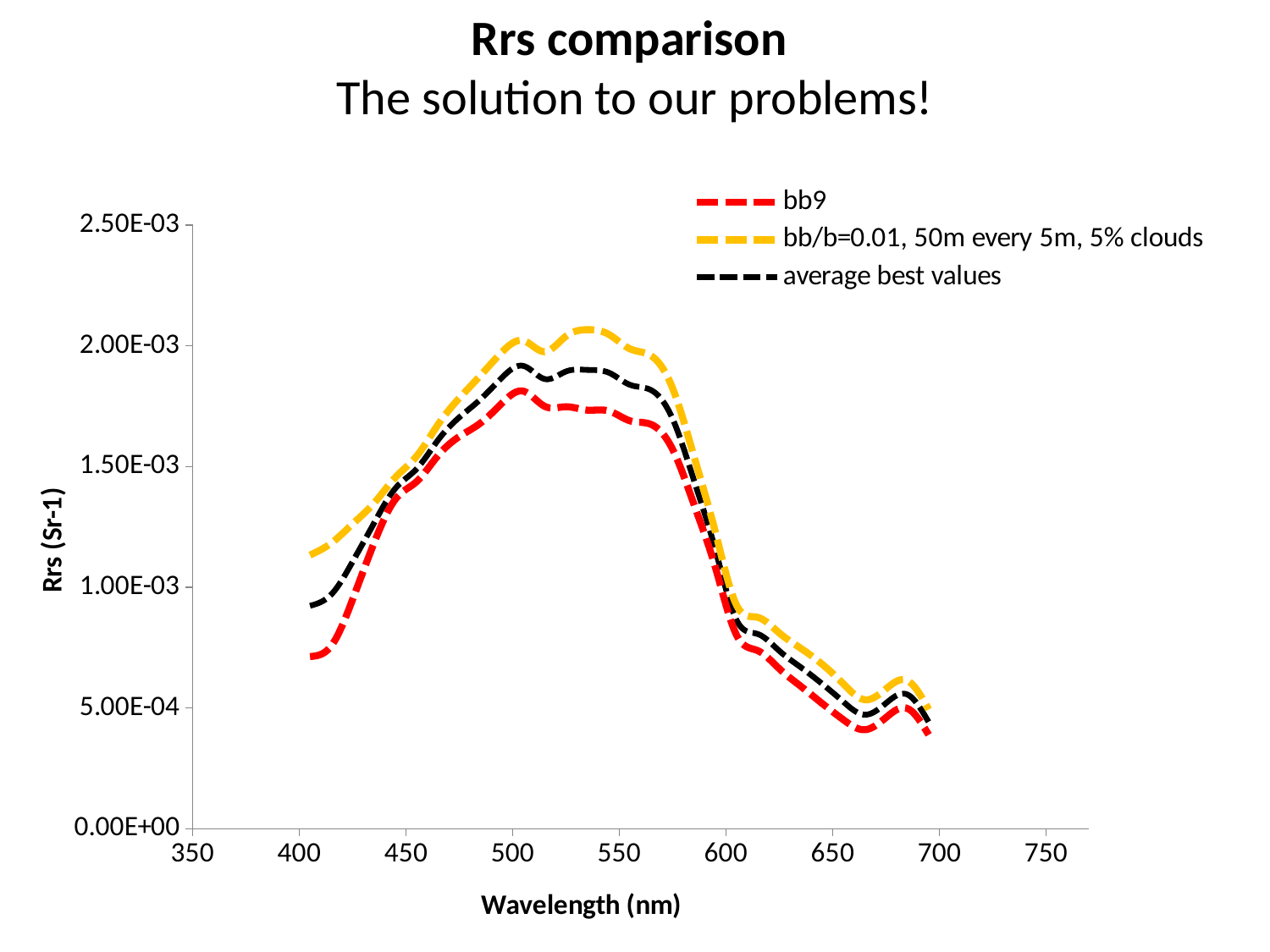
Is the peak value of the bb/b=0.01, 50m every 5m, 5% clouds series greater or less than 2.00E-03? greater Is the peak value of the bb9 series greater or less than 2.00E-03? less Which series has the highest value at 550 nm? bb/b=0.01, 50m every 5m, 5% clouds What is the title of the y axis? Rrs (Sr-1) What is the title of the x axis? Wavelength (nm) What kind of chart is shown on the slide? line chart Do the values of the bb9 series rise or fall between 600 nm and 650 nm? fall Do the values of the average best values series rise or fall between 400 nm and 500 nm? rise How many series does the legend list? 3